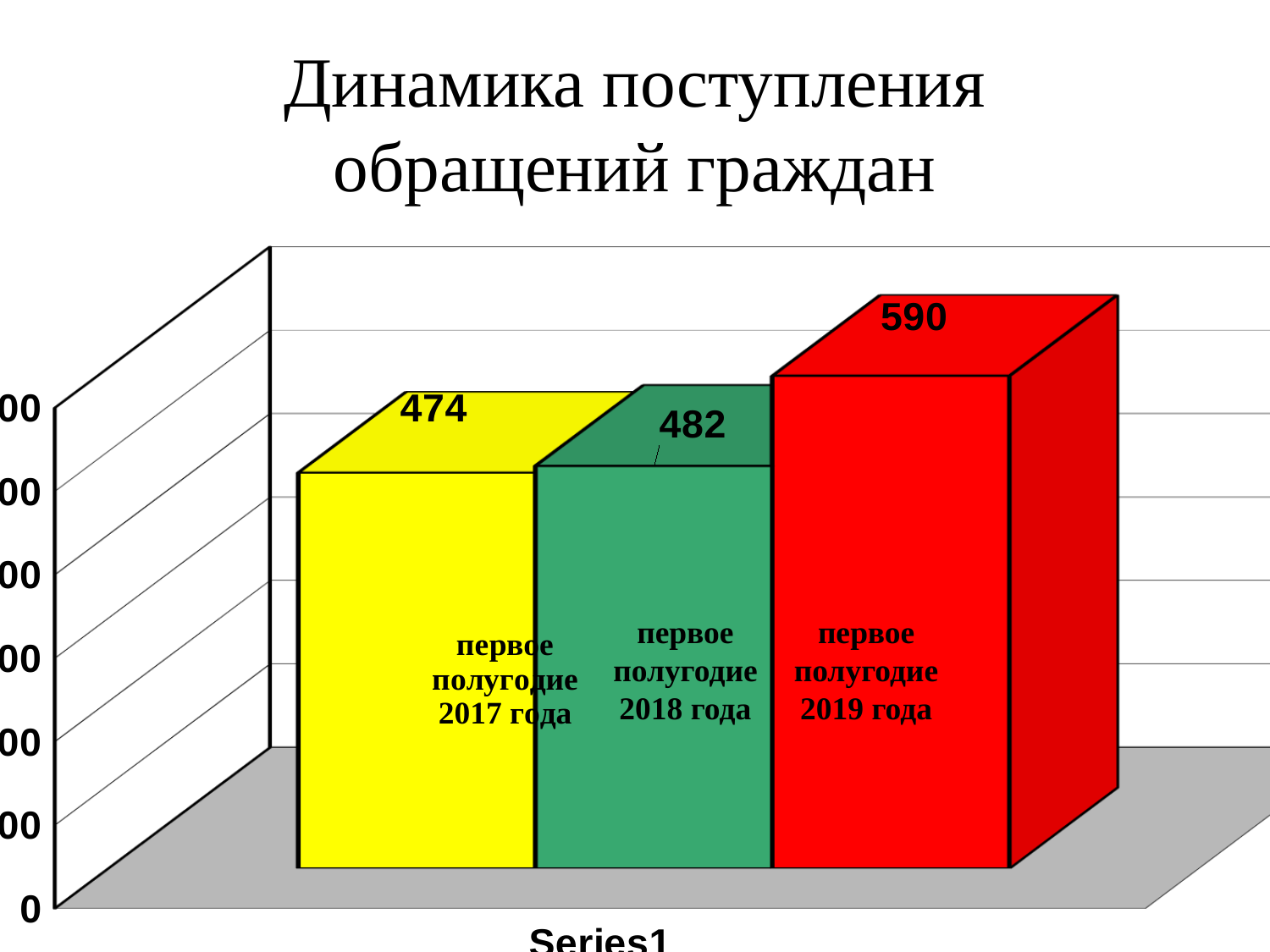
What kind of chart is shown on the slide? bar chart Which period has the lowest value? первое полугодие 2017 года What is the value for первое полугодие 2019 года? 590 What is the difference between the values for первое полугодие 2019 года and первое полугодие 2017 года? 116 What is the title of the chart? Динамика поступления обращений граждан What is the value for первое полугодие 2018 года? 482 Do the values rise or fall from 2017 to 2019? rise What is the value for первое полугодие 2017 года? 474 Which is larger, the value for первое полугодие 2018 года or первое полугодие 2019 года? первое полугодие 2019 года Which period has the highest value? первое полугодие 2019 года What is the difference between the values for первое полугодие 2018 года and первое полугодие 2017 года? 8 How many bars are shown in the chart? 3